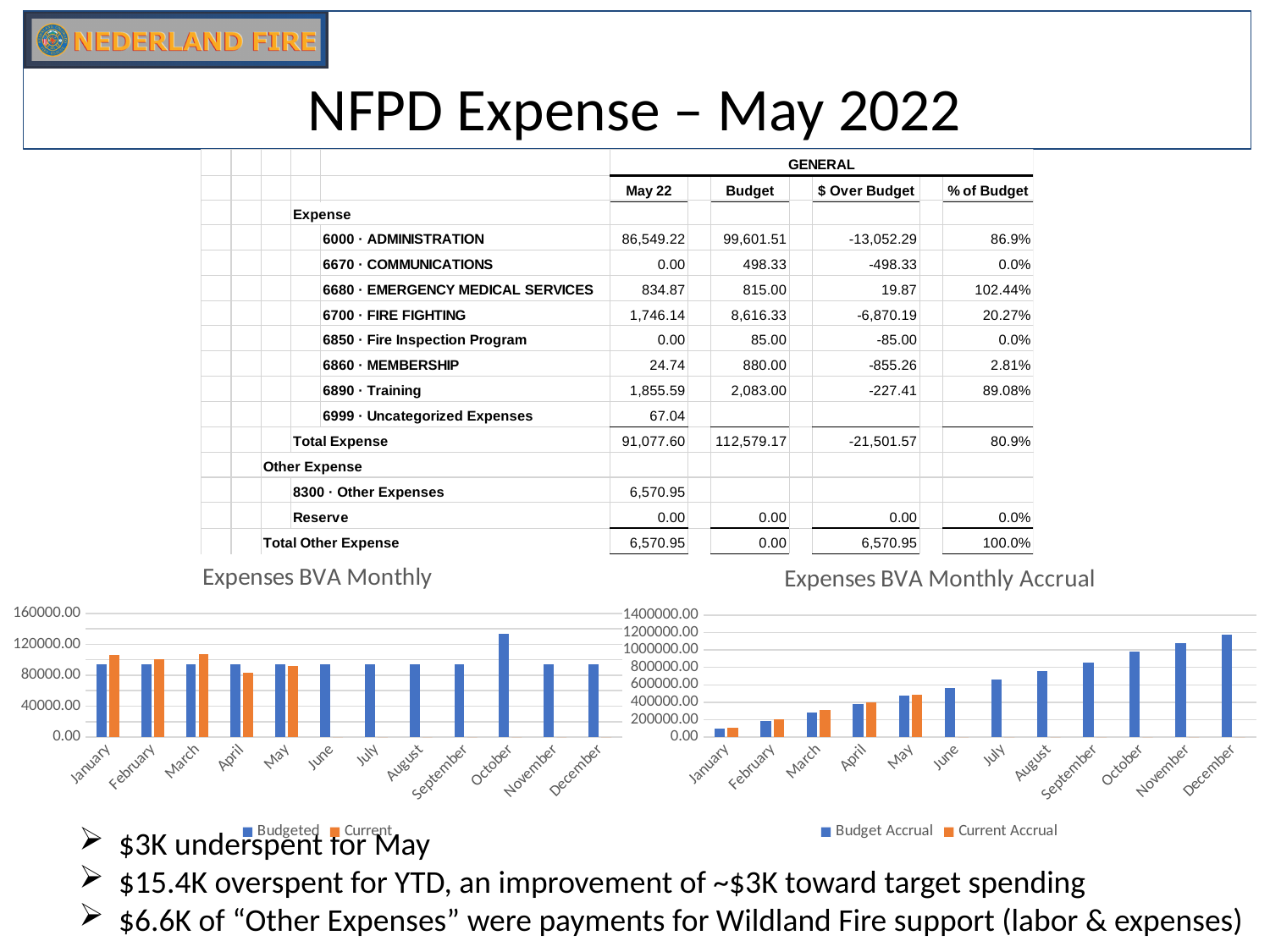
In the "Expenses BVA Monthly" chart, which is larger for January, the Budgeted bar or the Current bar? Current In the "Expenses BVA Monthly" chart, which is larger for April, the Budgeted bar or the Current bar? Budgeted How many months are shown on the x axis of the "Expenses BVA Monthly" chart? 12 In the "Expenses BVA Monthly" chart, how many months have a Current bar? 5 In the "Expenses BVA Monthly" chart, is the Current value for April greater or less than 100000.00? less What are the two legend entries of the "Expenses BVA Monthly Accrual" chart? Budget Accrual and Current Accrual How many series does the legend of the "Expenses BVA Monthly Accrual" chart list? 2 In the "Expenses BVA Monthly" chart, is the Budgeted value for October greater or less than 120000.00? greater In the "Expenses BVA Monthly" chart, which month has the highest Budgeted bar? October What kind of chart is the "Expenses BVA Monthly" chart? Bar chart In the "Expenses BVA Monthly Accrual" chart, do the Budget Accrual values rise or fall from January to December? Rise In the "Expenses BVA Monthly Accrual" chart, is the Budget Accrual value for December greater or less than 1000000.00? greater